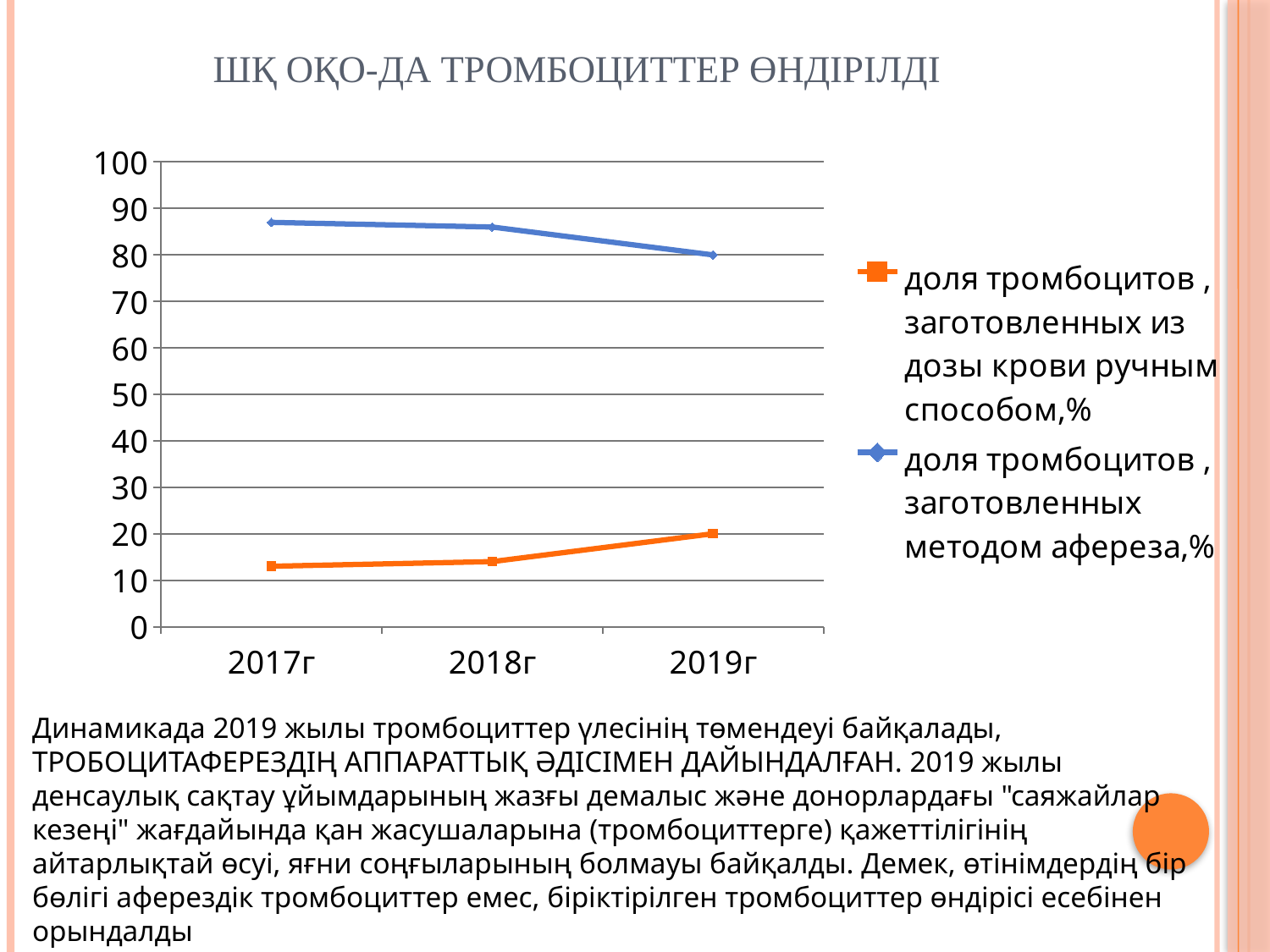
Is the value for 'доля тромбоцитов, заготовленных из дозы крови ручным способом,%' in 2017г greater or less than 20? less What is the value for 'доля тромбоцитов, заготовленных методом афереза,%' in 2019г? 80 Is the value for 'доля тромбоцитов, заготовленных методом афереза,%' in 2017г greater or less than 80? greater How many years are shown on the x axis? 3 How many series does the legend list? 2 In which year is the value for 'доля тромбоцитов, заготовленных из дозы крови ручным способом,%' highest? 2019г In which year is the value for 'доля тромбоцитов, заготовленных методом афереза,%' lowest? 2019г What kind of chart is shown on the slide? line chart Does the series 'доля тромбоцитов, заготовленных методом афереза,%' rise or fall from 2017г to 2019г? fall In 2018г, which series has the larger value: the one prepared by apheresis or the one prepared manually from blood doses? доля тромбоцитов, заготовленных методом афереза,% What colour is the line for 'доля тромбоцитов, заготовленных методом афереза,%'? blue Does the series 'доля тромбоцитов, заготовленных из дозы крови ручным способом,%' rise or fall from 2017г to 2019г? rise